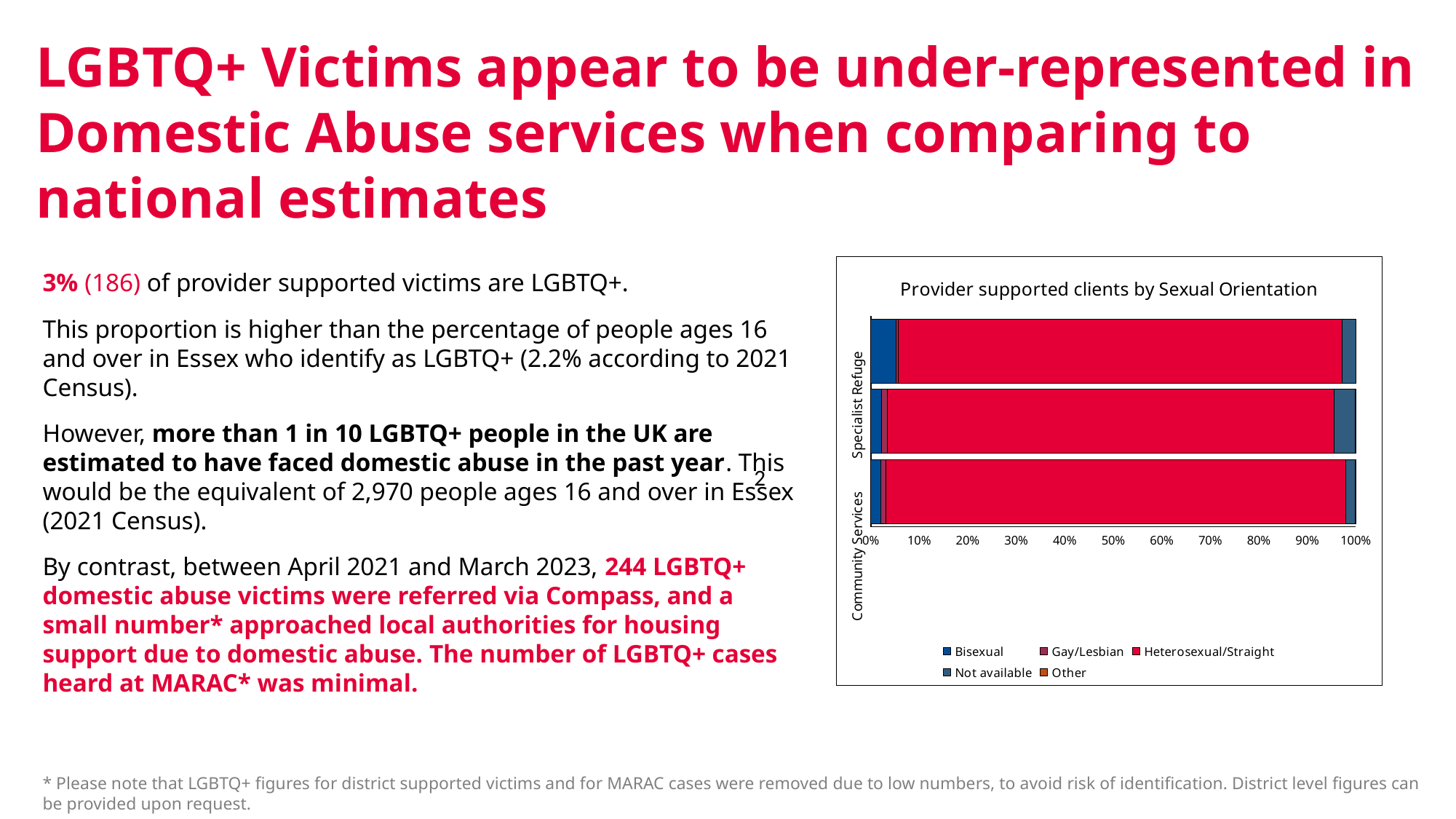
In the middle bar of the chart, is the Not available share greater or less than 10%? less What kind of chart is shown on the slide? Stacked bar chart How many series does the chart's legend list? 5 How many bars are plotted in the chart? 3 In the top bar of the chart, which is larger: the Heterosexual/Straight share or the Bisexual share? Heterosexual/Straight In the top bar of the chart, is the Bisexual share greater or less than 10%? less In the top bar of the chart, is the Heterosexual/Straight share greater or less than 80%? greater What is the title of the chart? Provider supported clients by Sexual Orientation Which series are listed in the chart's legend? Bisexual, Gay/Lesbian, Heterosexual/Straight, Not available, Other Which series takes up the largest share in every bar of the chart? Heterosexual/Straight